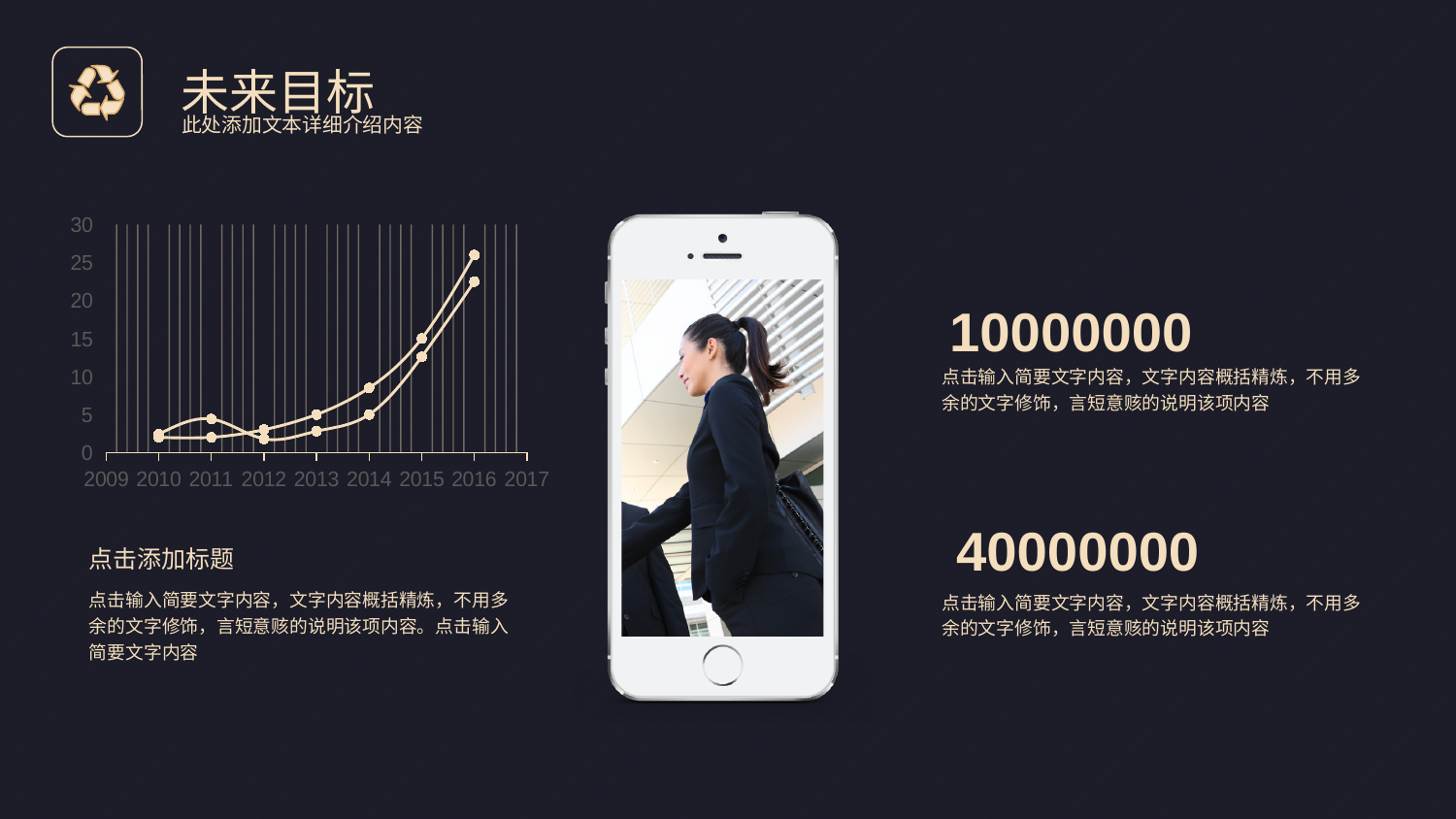
Is the value of the lower line in 2016 greater or less than 20? greater What is the first year label on the x axis of the chart? 2009 Is the value of the upper line in 2014 greater or less than 10? less What is the highest value shown on the y axis of the chart? 30 Is the value of the upper line in 2016 greater or less than 25? greater How many lines are plotted on the chart? 2 Do the values on the chart generally rise or fall from 2010 to 2016? rise Which year has the larger value on the upper line, 2013 or 2015? 2015 What kind of chart is shown on the left of the slide? line chart What is the last year label on the x axis of the chart? 2017 In which year does the upper line reach its highest value? 2016 How many year labels appear on the x axis of the chart? 9